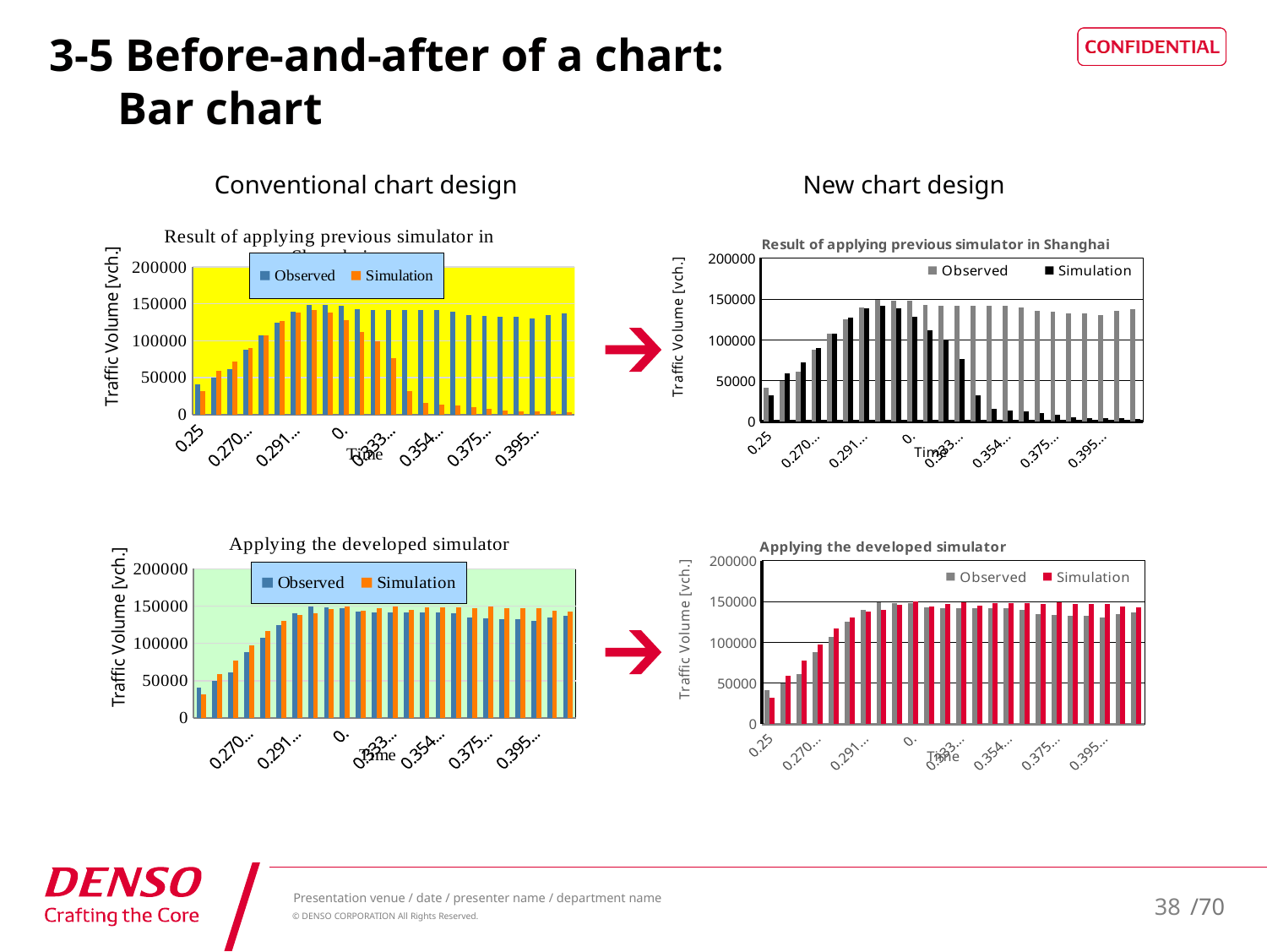
In the top-right chart "Result of applying previous simulator in Shanghai", is the Observed value at 0.25 greater or less than 50000? less In the top-right chart "Result of applying previous simulator in Shanghai", is the Simulation value at 0.395... greater or less than 50000? less In the top-right chart "Result of applying previous simulator in Shanghai", do the Simulation values rise or fall along the x axis after 0.291...? fall In the top-right chart "Result of applying previous simulator in Shanghai", which series is larger at 0.395..., Observed or Simulation? Observed In the bottom-right chart "Applying the developed simulator", is the Observed value at 0.354... greater or less than 100000? greater What kind of chart is the top-right chart titled "Result of applying previous simulator in Shanghai"? bar chart What is the highest tick value shown on the y axis of the bottom-left chart "Applying the developed simulator"? 200000 In the top-right chart "Result of applying previous simulator in Shanghai", what colour are the Simulation bars? black What are the two legend entries in the top-left chart under "Conventional chart design"? Observed and Simulation How many series does the legend list in the bottom-right chart titled "Applying the developed simulator"? 2